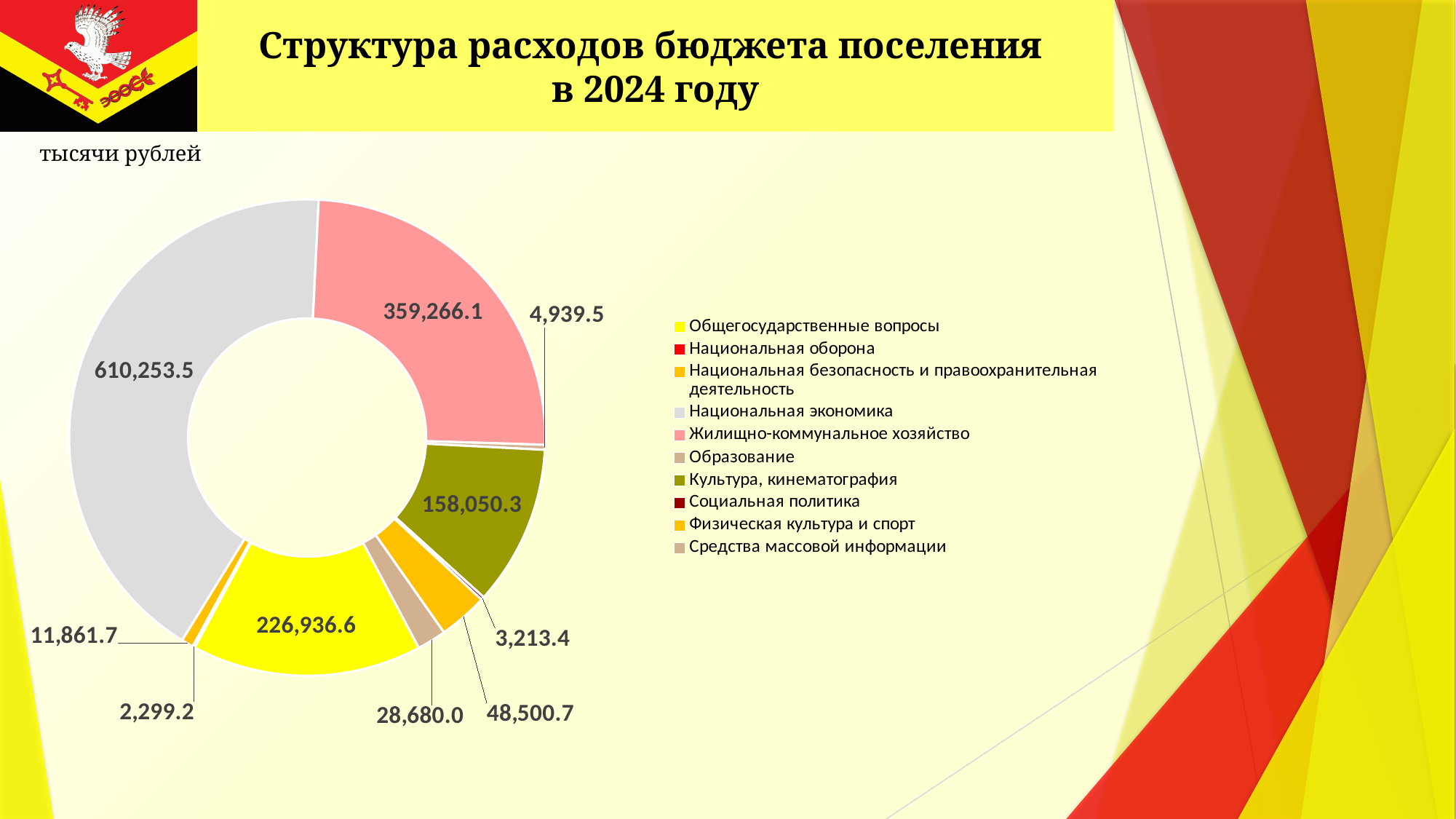
What is the difference between Национальная экономика and Жилищно-коммунальное хозяйство? 250,987.4 What kind of chart is shown on the slide? Doughnut (pie) chart How many categories does the legend of the chart list? 10 Which category has the smallest expenditure? Национальная оборона What is the value for Физическая культура и спорт? 48,500.7 What is the value for Жилищно-коммунальное хозяйство? 359,266.1 Which is larger: Общегосударственные вопросы or Культура, кинематография? Общегосударственные вопросы In what units are the values on the chart given, according to the slide? тысячи рублей What is the value for Культура, кинематография? 158,050.3 What is the value for Национальная экономика? 610,253.5 What is the value for Общегосударственные вопросы? 226,936.6 Which category has the largest expenditure? Национальная экономика